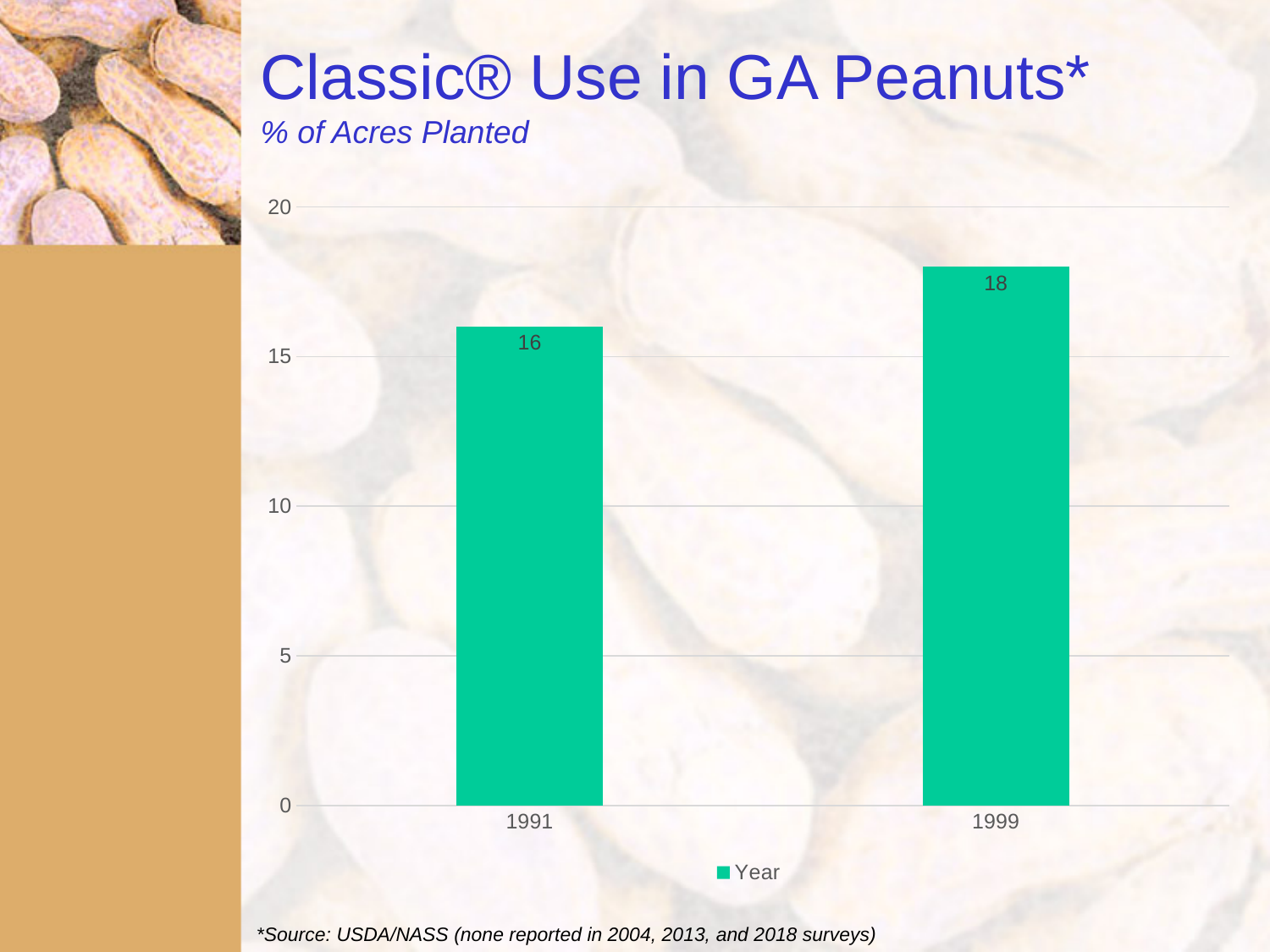
How many series does the legend list? 1 What is the value for 1999? 18 Is the value for 1991 greater or less than 20? less What is the difference between the values for 1999 and 1991? 2 Which is larger, the value for 1991 or the value for 1999? 1999 How many years are shown on the x axis? 2 Is the value for 1999 greater or less than 15? greater Do the values rise or fall from 1991 to 1999? Rise What kind of chart is shown on the slide? Bar chart Which year has the lowest value? 1991 Which year has the highest value? 1999 What is the value for 1991? 16